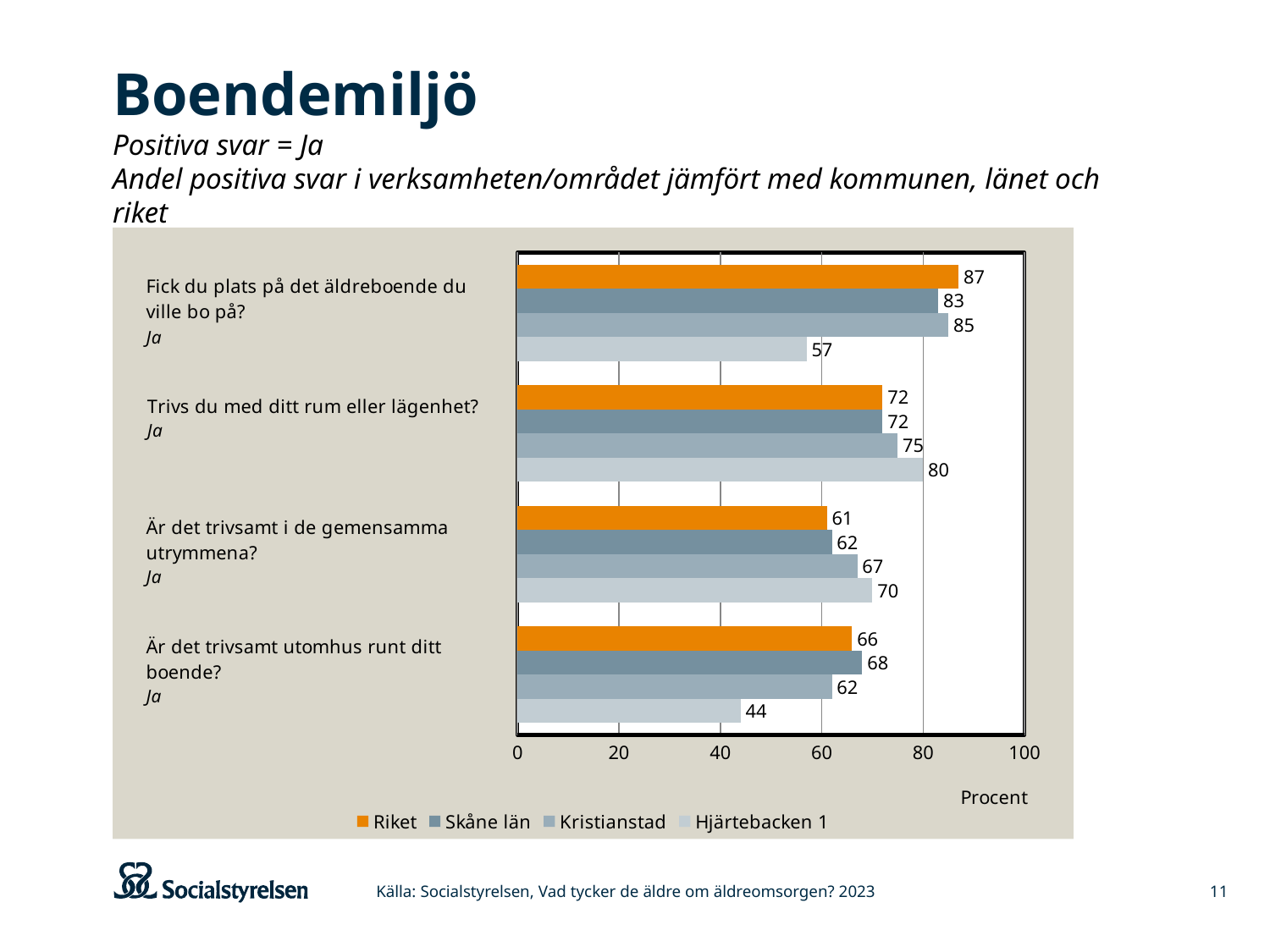
How many questions (categories) are shown on the chart? 4 Which is larger for "Trivs du med ditt rum eller lägenhet?": Hjärtebacken 1 or Kristianstad? Hjärtebacken 1 What is the difference between Kristianstad and Hjärtebacken 1 for "Fick du plats på det äldreboende du ville bo på?" 28 What is the value for Hjärtebacken 1 for "Fick du plats på det äldreboende du ville bo på?" 57 What is the value for Kristianstad for "Är det trivsamt i de gemensamma utrymmena?" 67 What is the value for Riket for "Trivs du med ditt rum eller lägenhet?" 72 How many series does the legend list? 4 Which question has the lowest value for Hjärtebacken 1? Är det trivsamt utomhus runt ditt boende? Which series has the highest value for "Fick du plats på det äldreboende du ville bo på?" Riket What kind of chart is shown on the slide? Bar chart What is the label on the horizontal axis? Procent What is the value for Skåne län for "Är det trivsamt utomhus runt ditt boende?" 68